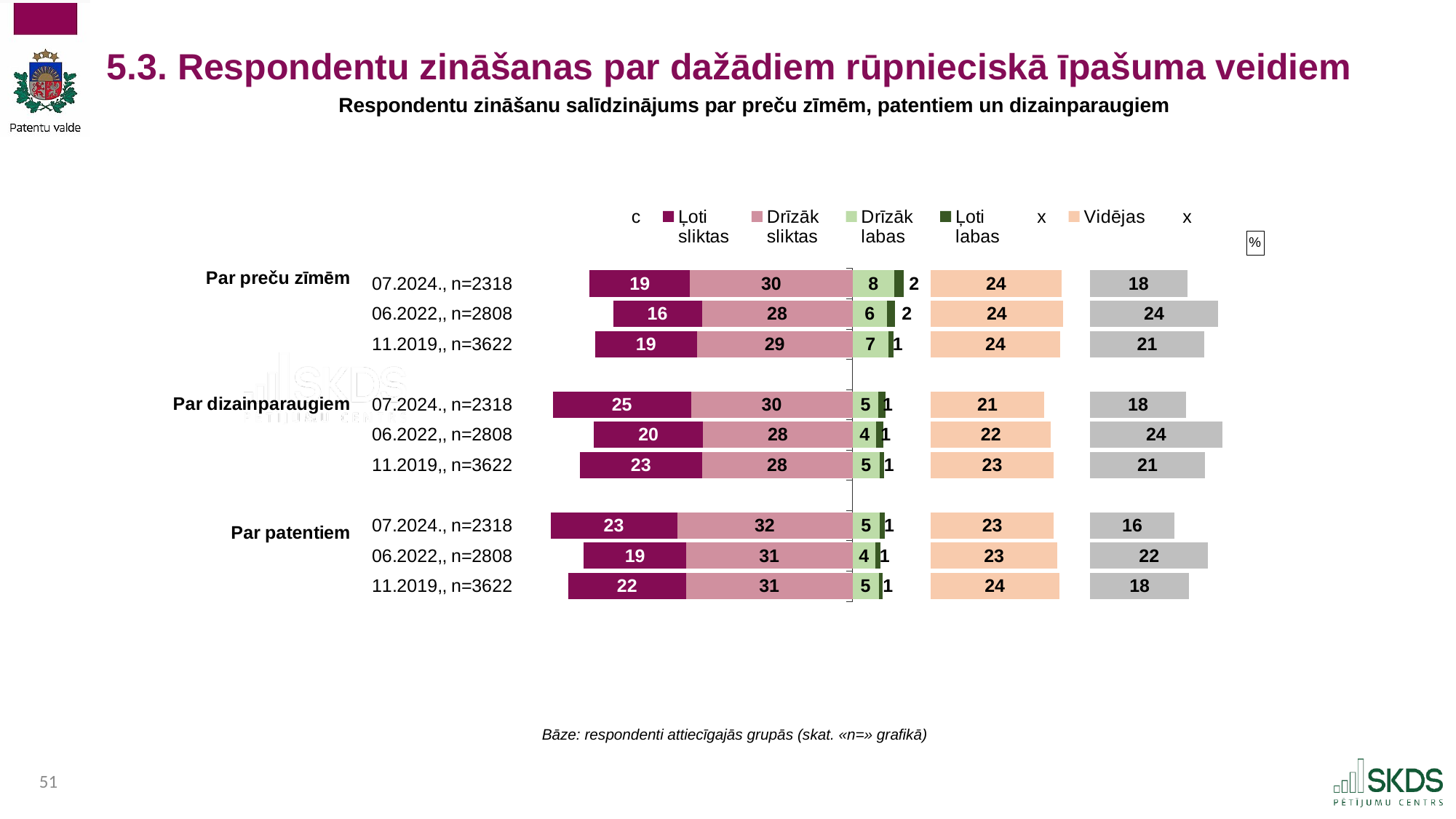
Among the three 07.2024., n=2318 rows, which category has the highest "Ļoti sliktas" value? Par dizainparaugiem What kind of chart is shown on the slide? Stacked bar chart What is the value of "Drīzāk sliktas" for "Par patentiem" in the 07.2024., n=2318 row? 32 What is the value of "Vidējas" for "Par preču zīmēm" in the 06.2022,, n=2808 row? 24 What is the value of "Ļoti sliktas" for "Par dizainparaugiem" in the 07.2024., n=2318 row? 25 How many bars (rows) are shown in the chart? 9 What is the value of "Ļoti labas" for "Par preču zīmēm" in the 06.2022,, n=2808 row? 2 What is the difference between the "Ļoti sliktas" values for "Par dizainparaugiem" in 07.2024., n=2318 and 06.2022,, n=2808? 5 What is the value of "Drīzāk labas" for "Par preču zīmēm" in the 07.2024., n=2318 row? 8 What is the combined value of "Ļoti sliktas" and "Drīzāk sliktas" for "Par patentiem" in the 07.2024., n=2318 row? 55 In the 07.2024., n=2318 rows, which has the larger "Drīzāk sliktas" value: "Par patentiem" or "Par preču zīmēm"? Par patentiem Which row has the lowest "Vidējas" value in the chart? Par dizainparaugiem, 07.2024., n=2318